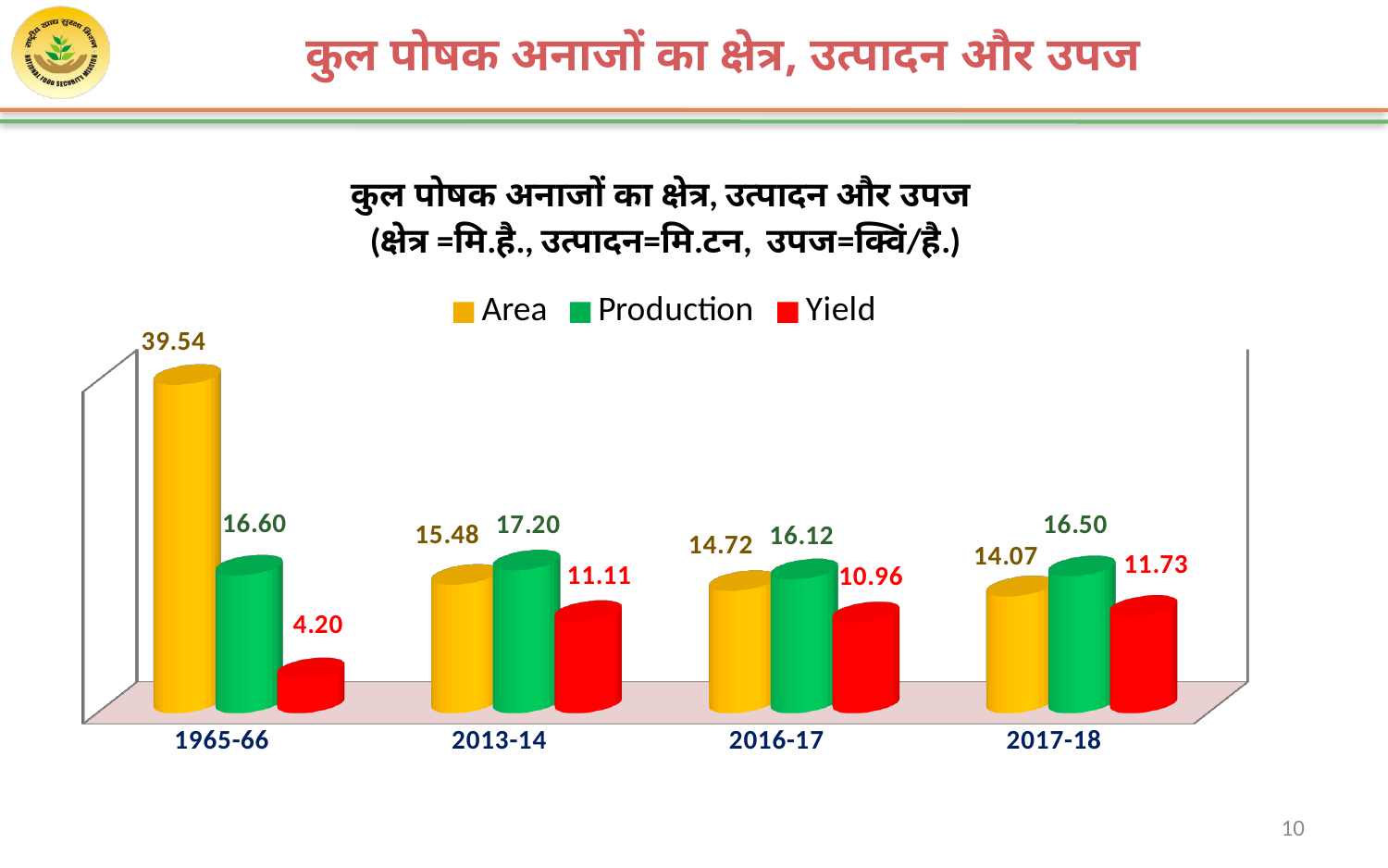
Which year has the lowest Yield value? 1965-66 Does the Area value rise or fall from 2013-14 to 2017-18? fall What is the Production value for 2016-17? 16.12 Which year has the highest Area value? 1965-66 What is the Yield value for 2017-18? 11.73 What kind of chart is shown on the slide? bar chart How many years are shown on the x axis? 4 How many series does the legend list? 3 What is the difference between the Production values for 2013-14 and 2016-17? 1.08 Which colour represents Yield in the legend? red Which is larger, the Area value for 2013-14 or the Area value for 2017-18? 2013-14 What is the Area value for 1965-66? 39.54